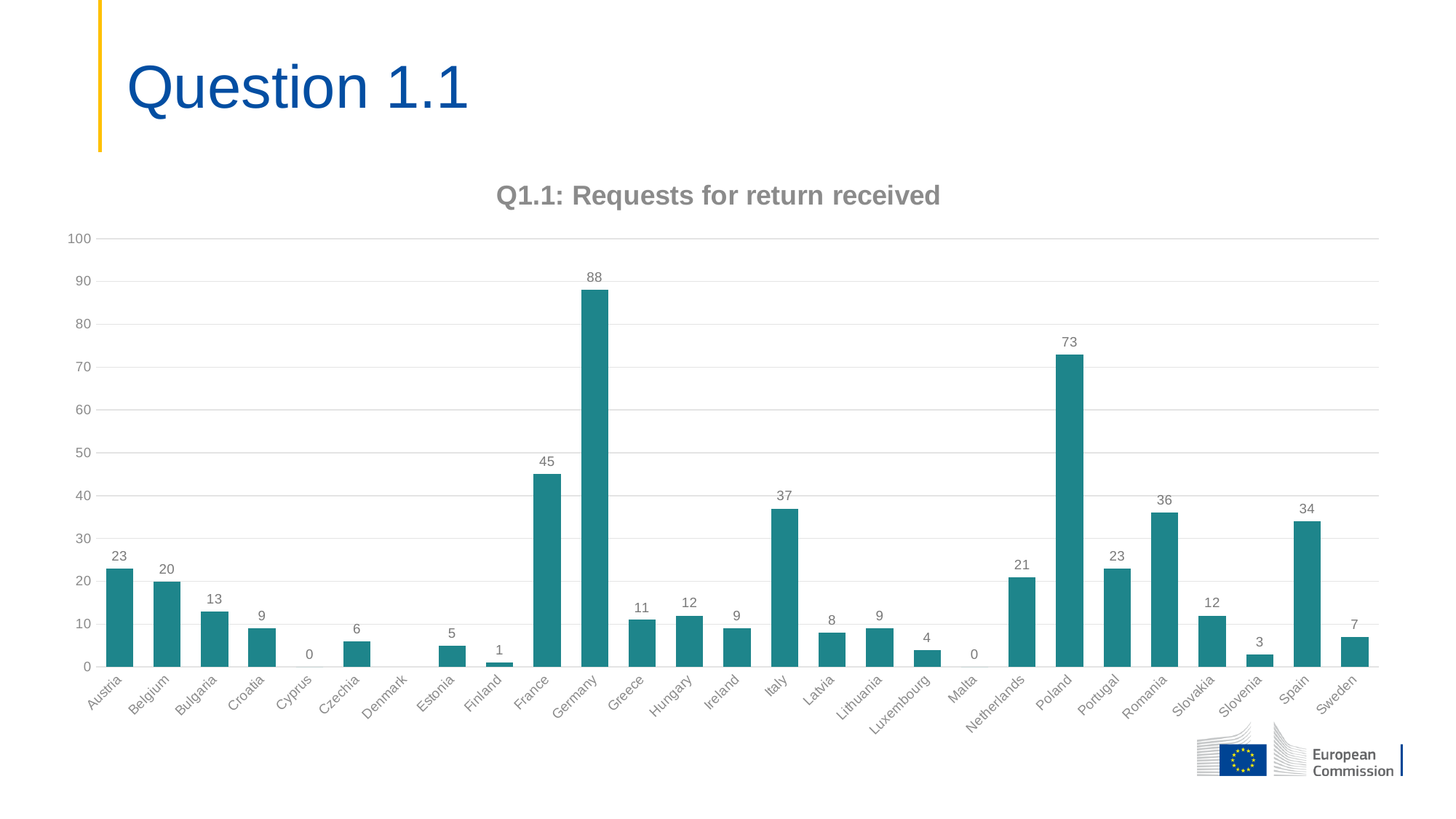
What kind of chart is shown on the slide? bar chart What is the difference between the values for France and Italy? 8 What is the difference between the values for Germany and Poland? 15 What is the value for Germany? 88 How many countries are shown on the x axis? 27 Is the value for Romania greater or less than 30? greater What is the value for Luxembourg? 4 Which country has the highest number of requests for return received? Germany Which is larger, the value for France or the value for Italy? France What is the value for Spain? 34 What is the value for Poland? 73 What is the title of the chart? Q1.1: Requests for return received